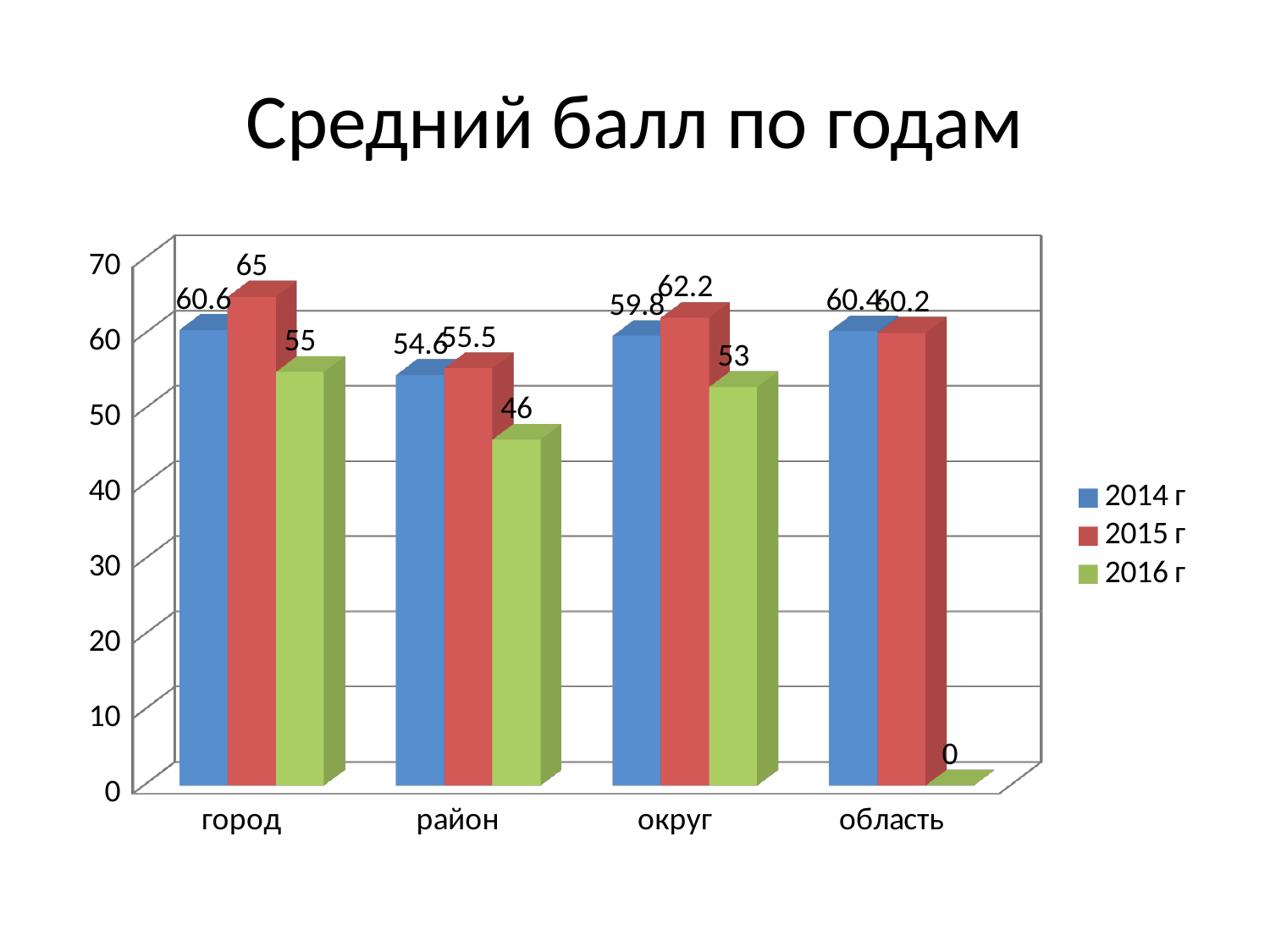
What is the value for город in the 2015 г series? 65 What is the title of the chart? Средний балл по годам What is the value for округ in the 2014 г series? 59.8 For район, which is larger: the 2014 г value or the 2015 г value? 2015 г Which category has the highest value in the 2015 г series? город How many series does the legend list? 3 What kind of chart is shown on the slide? bar chart Which category has the lowest value in the 2016 г series? область What is the value for область in the 2016 г series? 0 How many categories are shown on the x axis? 4 What is the value for район in the 2016 г series? 46 What is the difference between the 2015 г and 2016 г values for город? 10